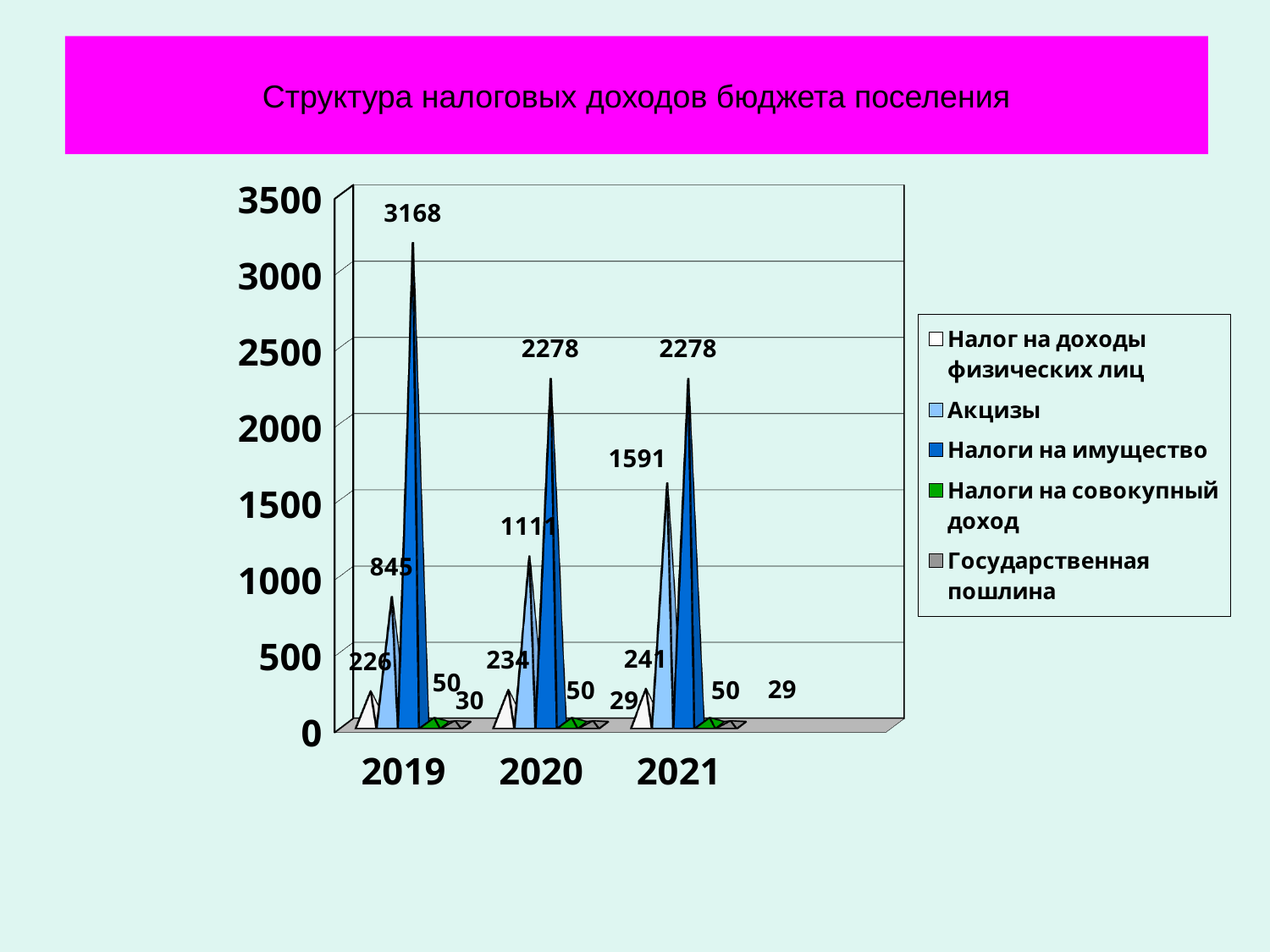
How many years are shown on the x axis? 3 What is the value of Акцизы in 2021? 1591 In which year is Налоги на имущество the highest? 2019 What is the value of Налоги на имущество in 2019? 3168 By how much did Акцизы increase from 2019 to 2021? 746 What is the value of Налоги на совокупный доход in 2021? 50 How many series does the legend list? 5 In 2020, which is larger: Акцизы or Налог на доходы физических лиц? Акцизы Do the values for Акцизы rise or fall from 2019 to 2021? rise In which year is Акцизы the lowest? 2019 What is the value of Налог на доходы физических лиц in 2020? 234 What is the title of the slide? Структура налоговых доходов бюджета поселения